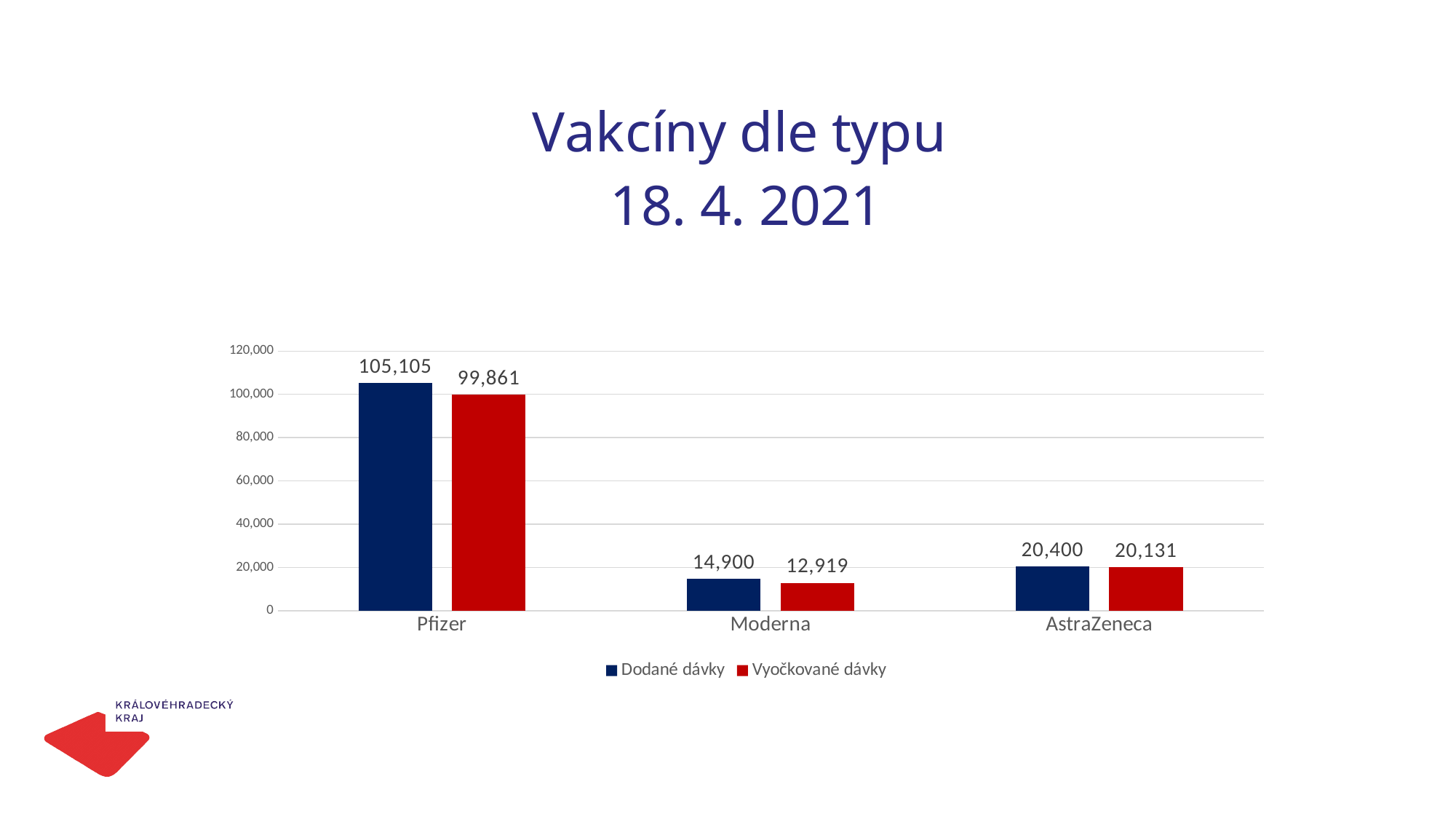
Which vaccine type has the lowest Vyočkované dávky value? Moderna What is the difference between Dodané dávky and Vyočkované dávky for AstraZeneca? 269 What is the value of Dodané dávky for Pfizer? 105,105 How many vaccine types are shown on the x axis? 3 What is the title of the slide? Vakcíny dle typu 18. 4. 2021 What is the value of Vyočkované dávky for Moderna? 12,919 Which is larger: Dodané dávky for Moderna or Dodané dávky for AstraZeneca? AstraZeneca How many series does the legend list? 2 What kind of chart is shown on the slide? Bar chart What is the value of Dodané dávky for AstraZeneca? 20,400 What is the difference between Dodané dávky and Vyočkované dávky for Pfizer? 5,244 Which vaccine type has the highest Dodané dávky value? Pfizer